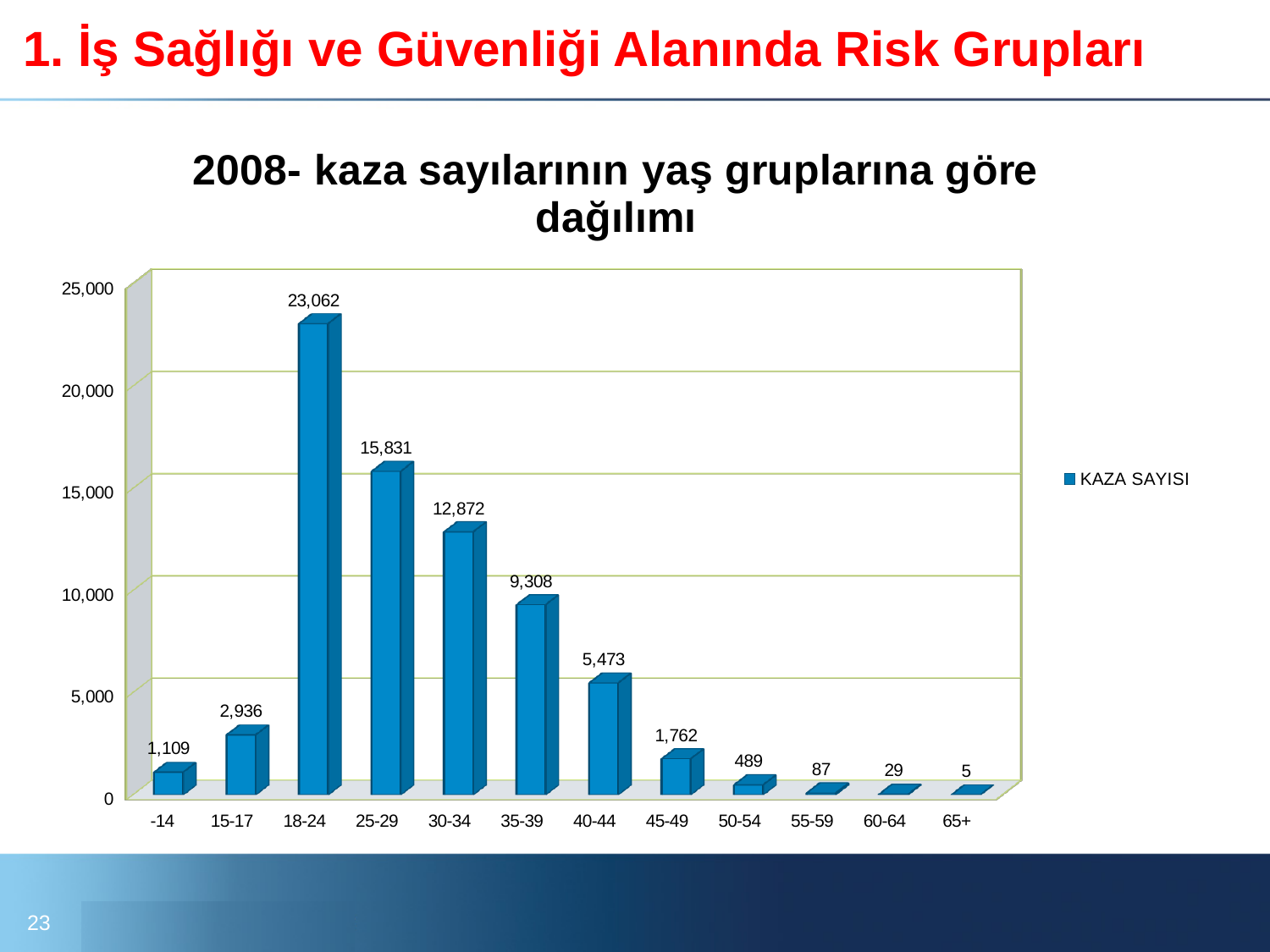
What is the value shown for the 65+ age group? 5 Which age group has a larger value, 35-39 or 40-44? 35-39 What is the number of accidents (KAZA SAYISI) for the 18-24 age group? 23,062 What is the title of the chart? 2008- kaza sayılarının yaş gruplarına göre dağılımı How many age groups are shown on the x axis? 12 What kind of chart is shown on the slide? Bar chart What is the difference between the values for the 25-29 and 30-34 age groups? 2,959 How many series does the legend list? 1 What is the value shown for the 30-34 age group? 12,872 Which age group has the lowest number of accidents? 65+ Is the value for the 25-29 age group greater or less than 15,000? greater Which age group has the highest number of accidents? 18-24